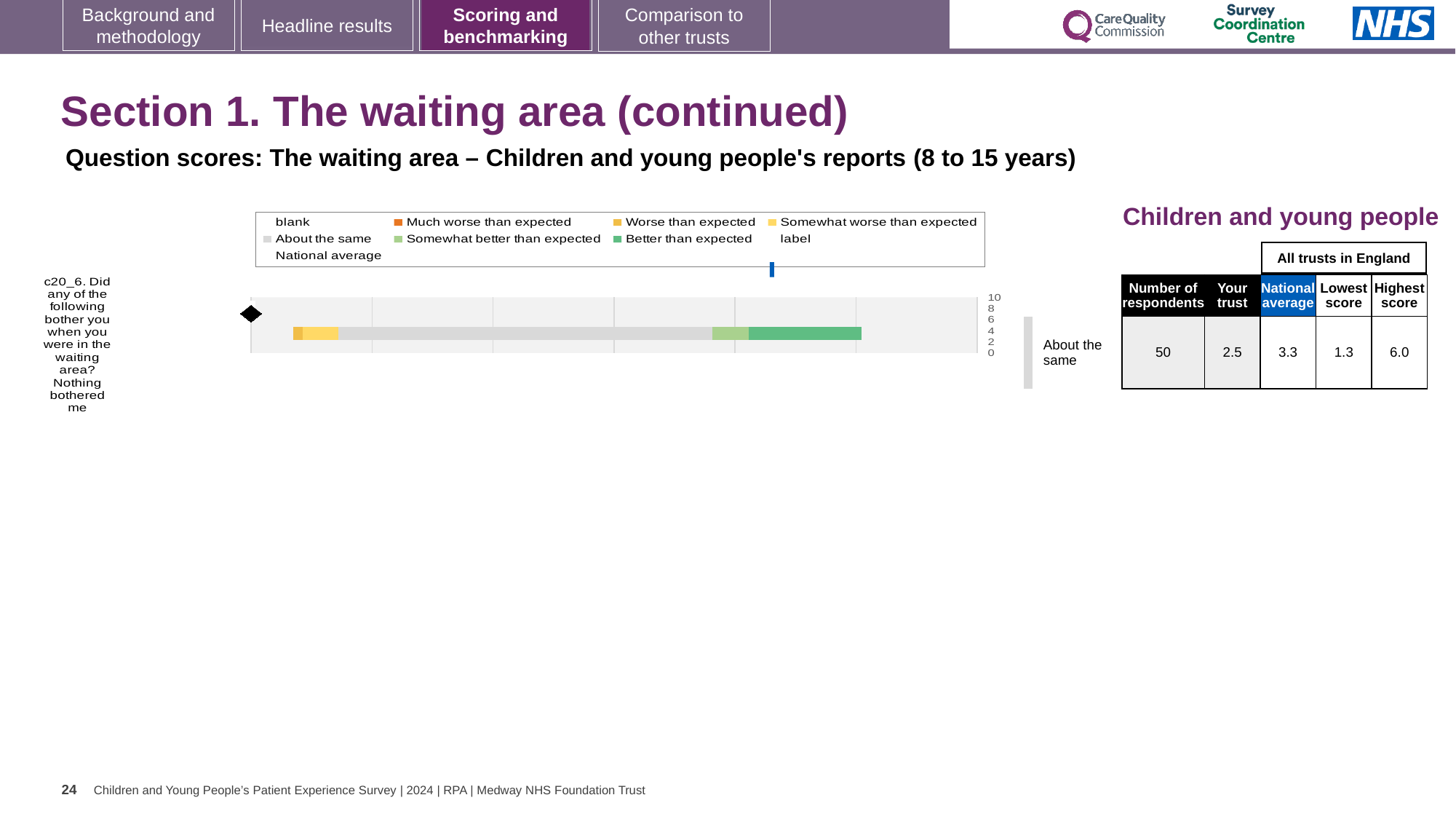
What is the highest score among all trusts in England for question c20_6? 6.0 How many respondents answered question c20_6? 50 How many survey questions (categories) are plotted in the bar chart? 1 Which is larger for question c20_6: the 'Your trust' score or the national average? National average In the legend, what colour represents 'Better than expected'? green What is the national average score for question c20_6? 3.3 Is the 'Your trust' score for question c20_6 greater or less than 4? less What benchmark label is shown to the right of the bar for question c20_6? About the same What is the lowest score among all trusts in England for question c20_6? 1.3 What is the 'Your trust' score for question c20_6? 2.5 What kind of chart is shown on the slide? bar chart What is the difference between the highest score and the lowest score for question c20_6? 4.7